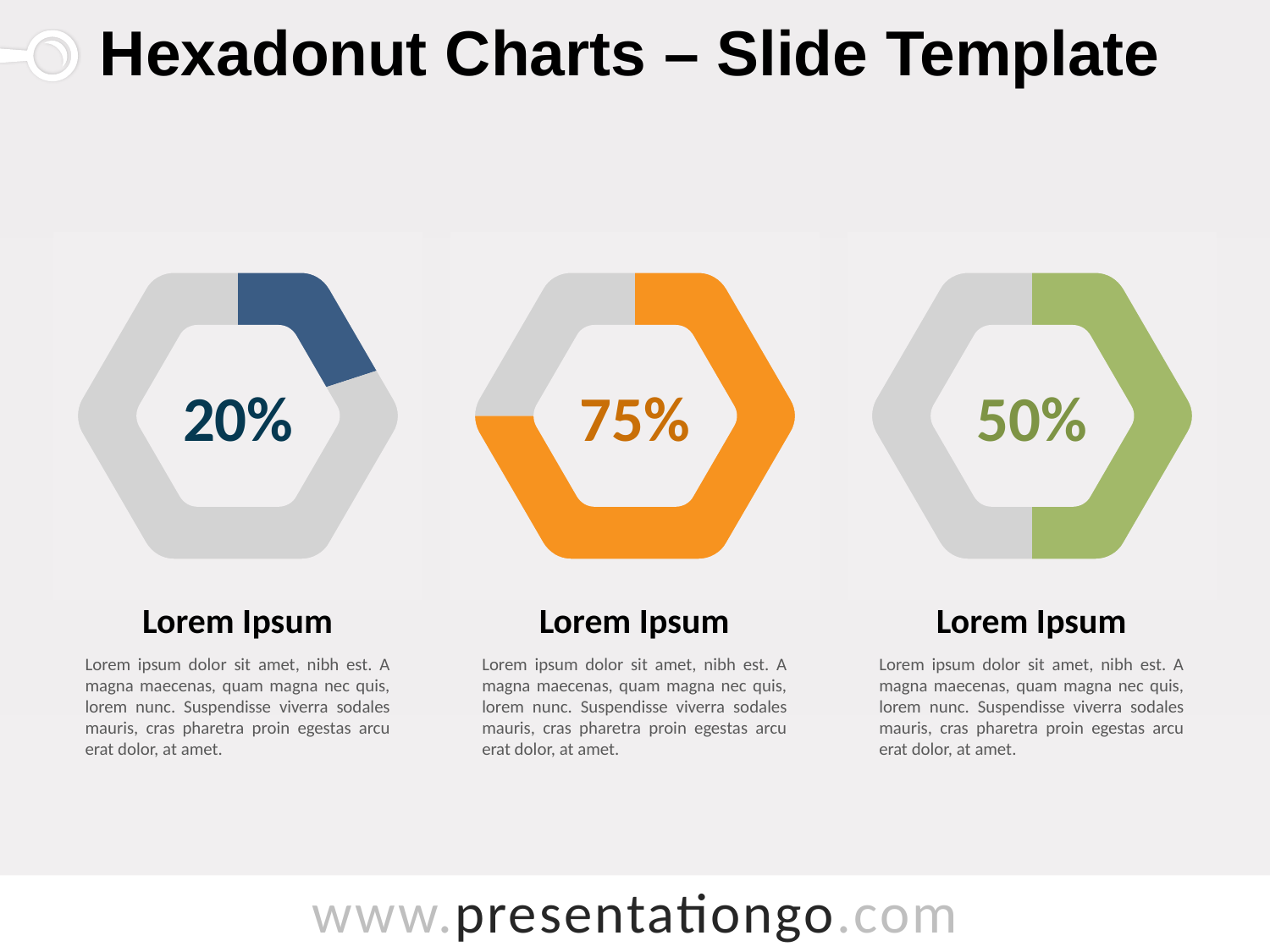
What value is shown in the right hexadonut chart? 50% Which of the three hexadonut charts shows the highest percentage: left, middle or right? middle How many hexadonut charts are on the slide? 3 Which of the three hexadonut charts shows the lowest percentage: left, middle or right? left What value is shown in the middle hexadonut chart? 75% What colour is the filled portion of the left hexadonut chart? blue Do the values rise or fall from the middle hexadonut chart to the right hexadonut chart? fall What is the difference between the value in the middle hexadonut chart and the value in the left hexadonut chart? 55% What value is shown in the left hexadonut chart? 20% What colour is the filled portion of the middle hexadonut chart? orange What is the difference between the value in the right hexadonut chart and the value in the left hexadonut chart? 30% Which is larger, the value in the right hexadonut chart or the value in the middle hexadonut chart? middle